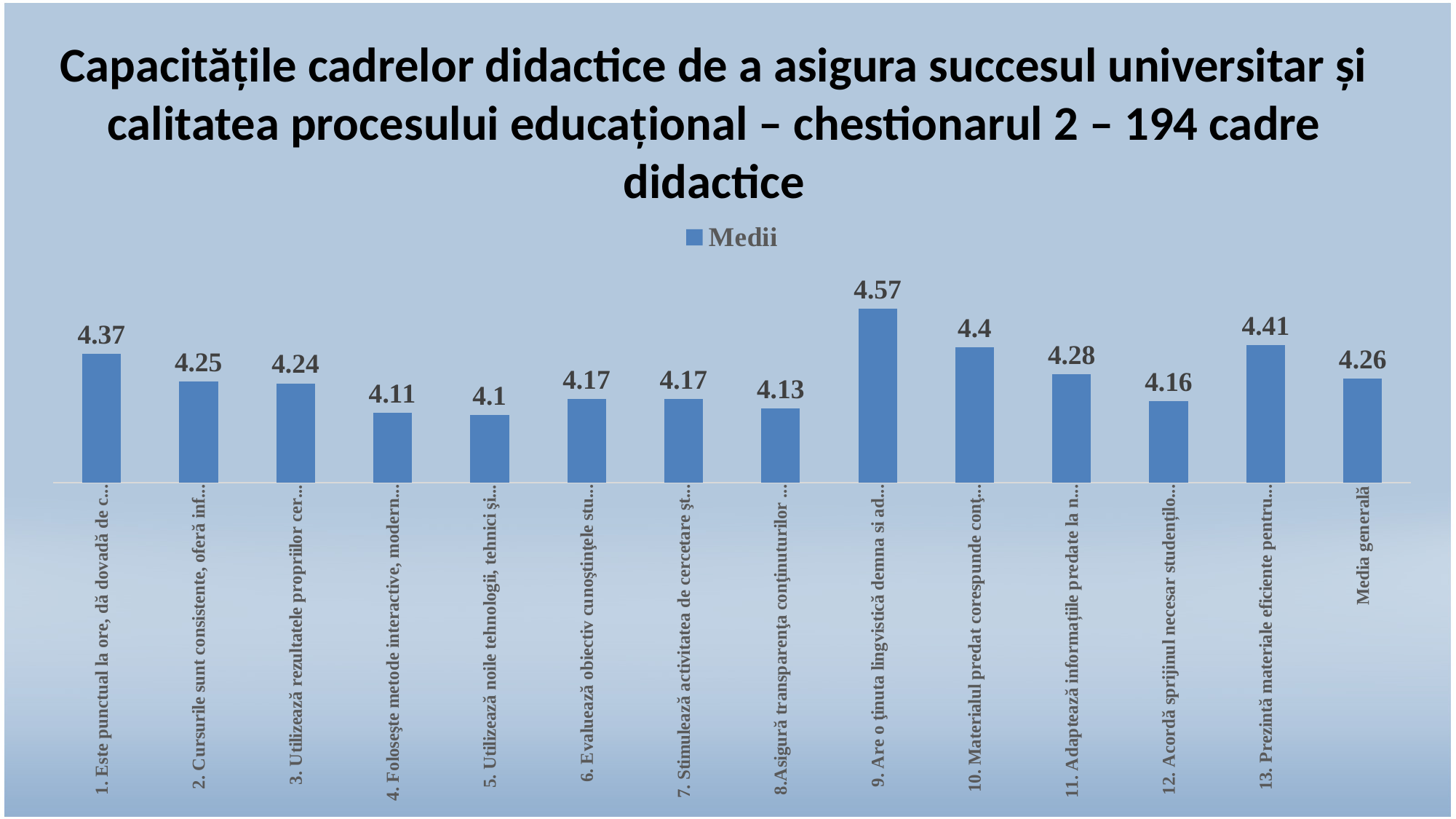
By how much does the value for category 1 (Este punctual la ore...) exceed the value for "Media generală"? 0.11 Which category has the lowest value in the chart? 5. Utilizează noile tehnologii, tehnici și... (4.1) What is the difference between the highest value (category 9) and the lowest value (category 5)? 0.47 What is the value of the bar labelled "Media generală"? 4.26 How many series does the legend list? 1 Which category has the highest value in the chart? 9. Are o ținuta lingvistică demna si ad... (4.57) Which has the larger value: category 1 (Este punctual la ore...) or category 13 (Prezintă materiale eficiente...)? Category 13 (4.41) What is the name of the series shown in the legend? Medii What is the value for category 10 (Materialul predat corespunde conț...)? 4.4 How many bars are plotted in the chart? 14 What kind of chart is shown on the slide? Bar chart What is the value for category 4 (Folosește metode interactive, modern...)? 4.11